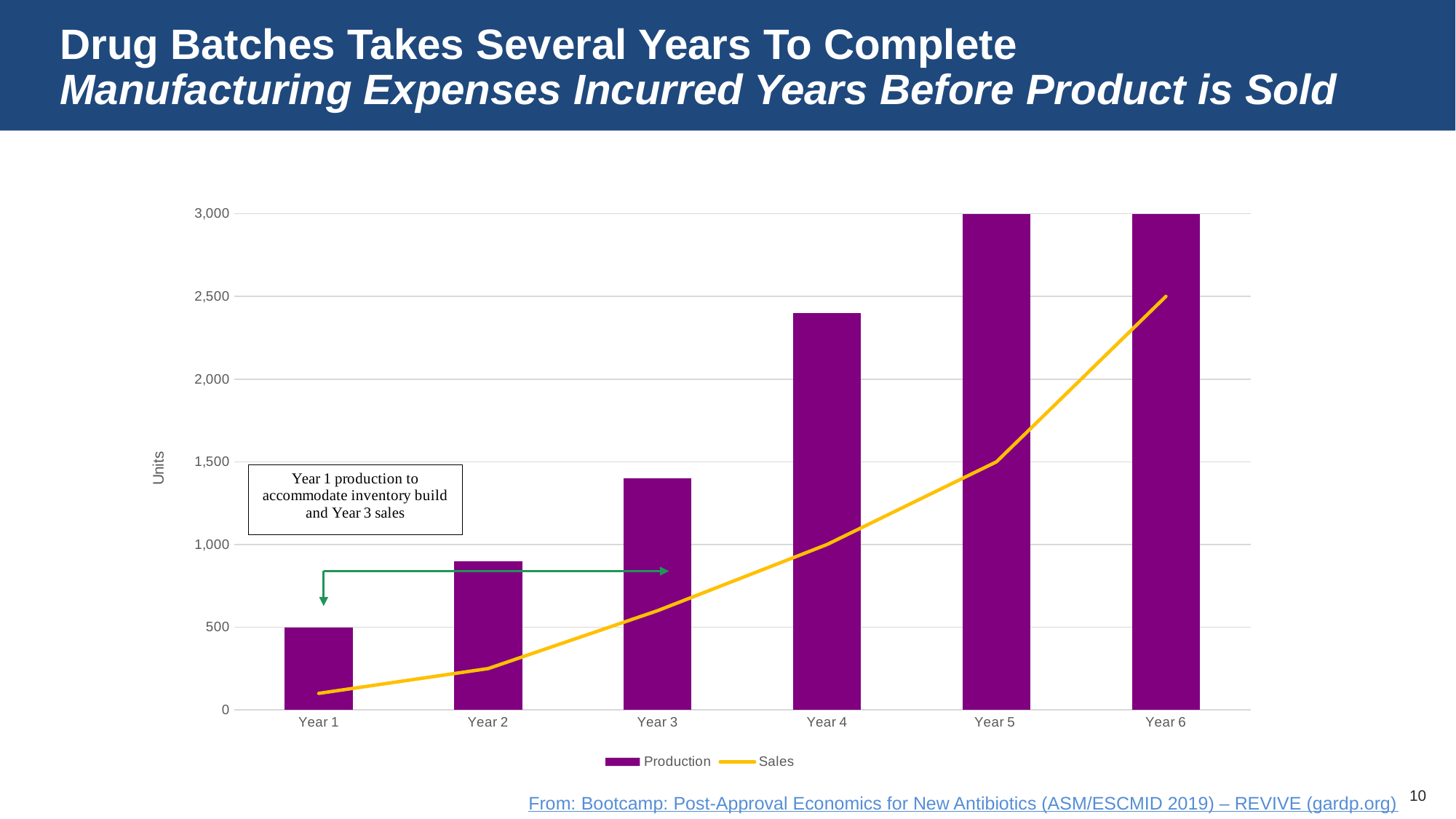
Does the Sales line rise or fall from Year 1 to Year 6? rises Which year has the lowest Production value? Year 1 How many years are shown on the x axis? 6 What is the Sales value for Year 6? 2,500 What is the Production value for Year 1? 500 Is the Production value for Year 4 greater or less than 2,000? greater What kind of chart is shown on the slide? bar chart with a line What is the Sales value for Year 5? 1,500 Is the Sales value for Year 2 greater or less than 500? less How many series does the legend list? 2